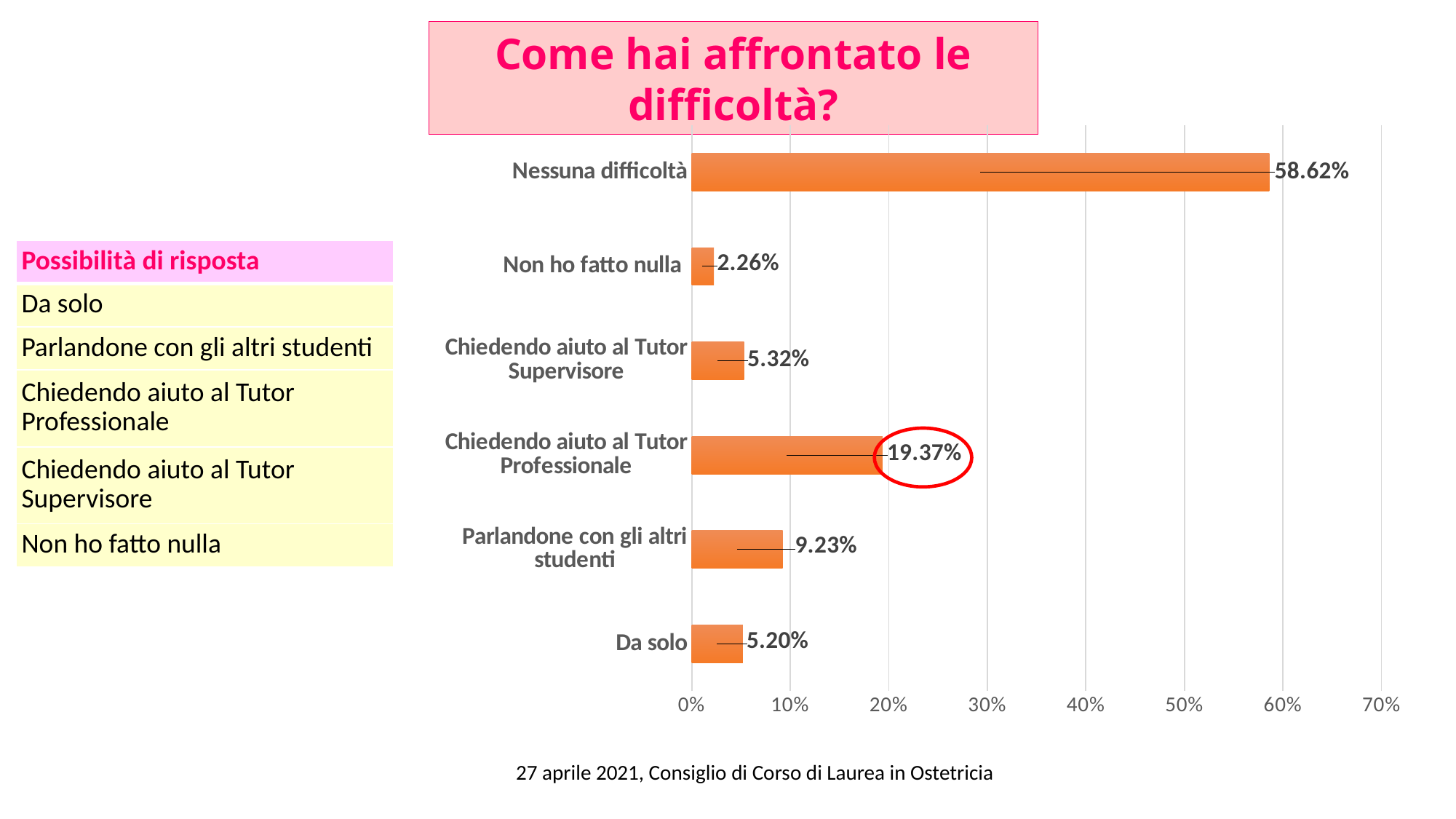
Is the value for "Nessuna difficoltà" greater or less than 50%? greater What is the difference between the values for "Nessuna difficoltà" and "Chiedendo aiuto al Tutor Professionale"? 39.25% What is the value for "Da solo"? 5.20% What is the value for "Chiedendo aiuto al Tutor Professionale"? 19.37% Which category has the highest value? Nessuna difficoltà How many categories are shown in the chart? 6 Which is larger, the value for "Chiedendo aiuto al Tutor Supervisore" or the value for "Parlandone con gli altri studenti"? Parlandone con gli altri studenti Which category has the lowest value? Non ho fatto nulla What is the title of the chart? Come hai affrontato le difficoltà? What is the value for "Nessuna difficoltà"? 58.62% What kind of chart is shown on the slide? bar chart What is the value for "Parlandone con gli altri studenti"? 9.23%